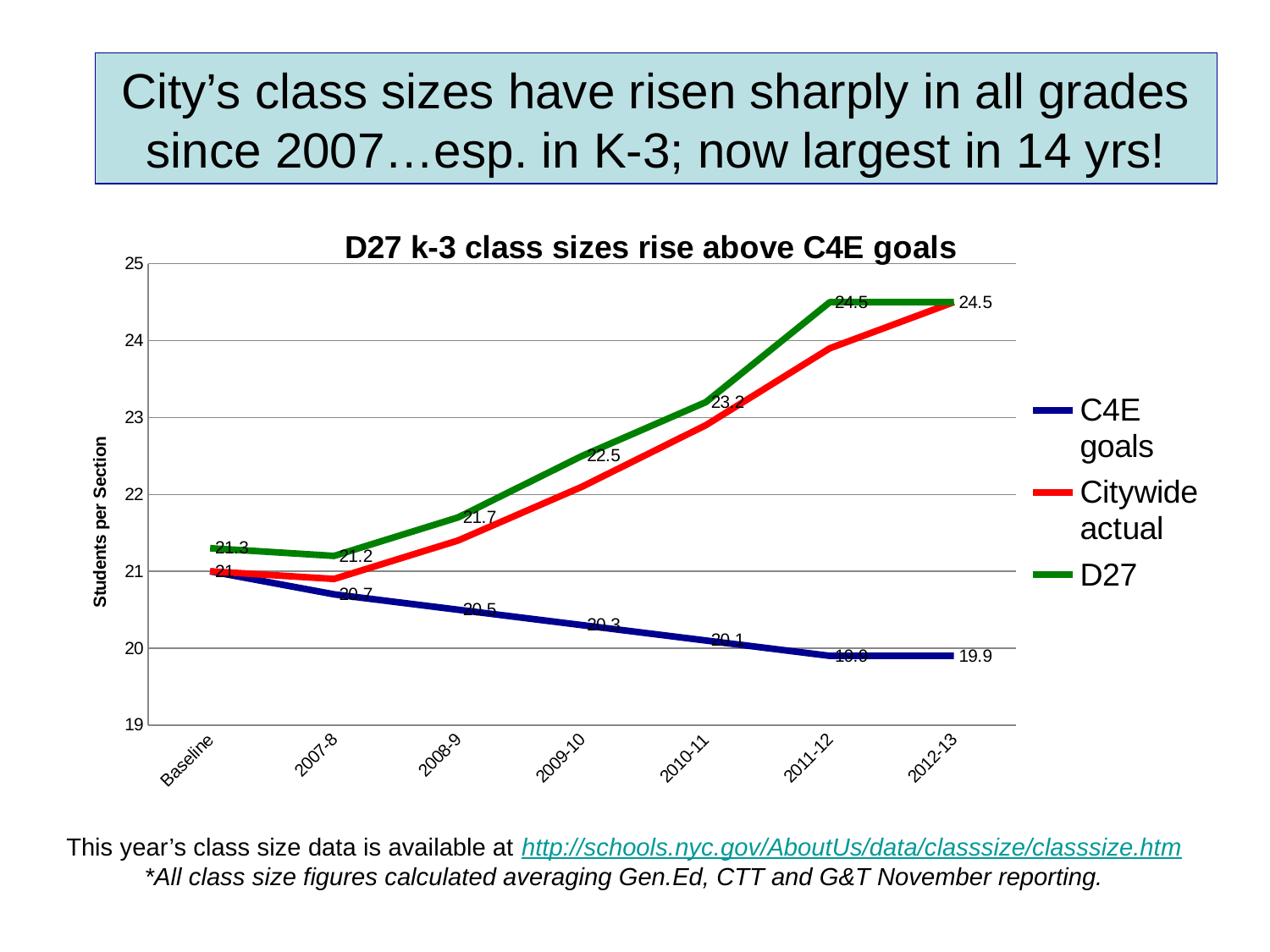
What is the D27 value for 2012-13? 24.5 Which series has the higher value in 2010-11, D27 or C4E goals? D27 What kind of chart is shown on the slide? line chart What is the D27 value for 2010-11? 23.2 How many series does the legend list? 3 Is the Citywide actual value for 2009-10 greater or less than 23? less What is the D27 value for 2009-10? 22.5 What is the C4E goals value for 2012-13? 19.9 What is the difference between the D27 value and the C4E goals value in 2012-13? 4.6 Do the C4E goals values rise or fall from Baseline to 2012-13? fall How many time periods are shown on the x axis? 7 Is the Citywide actual value for 2012-13 greater or less than 24? greater